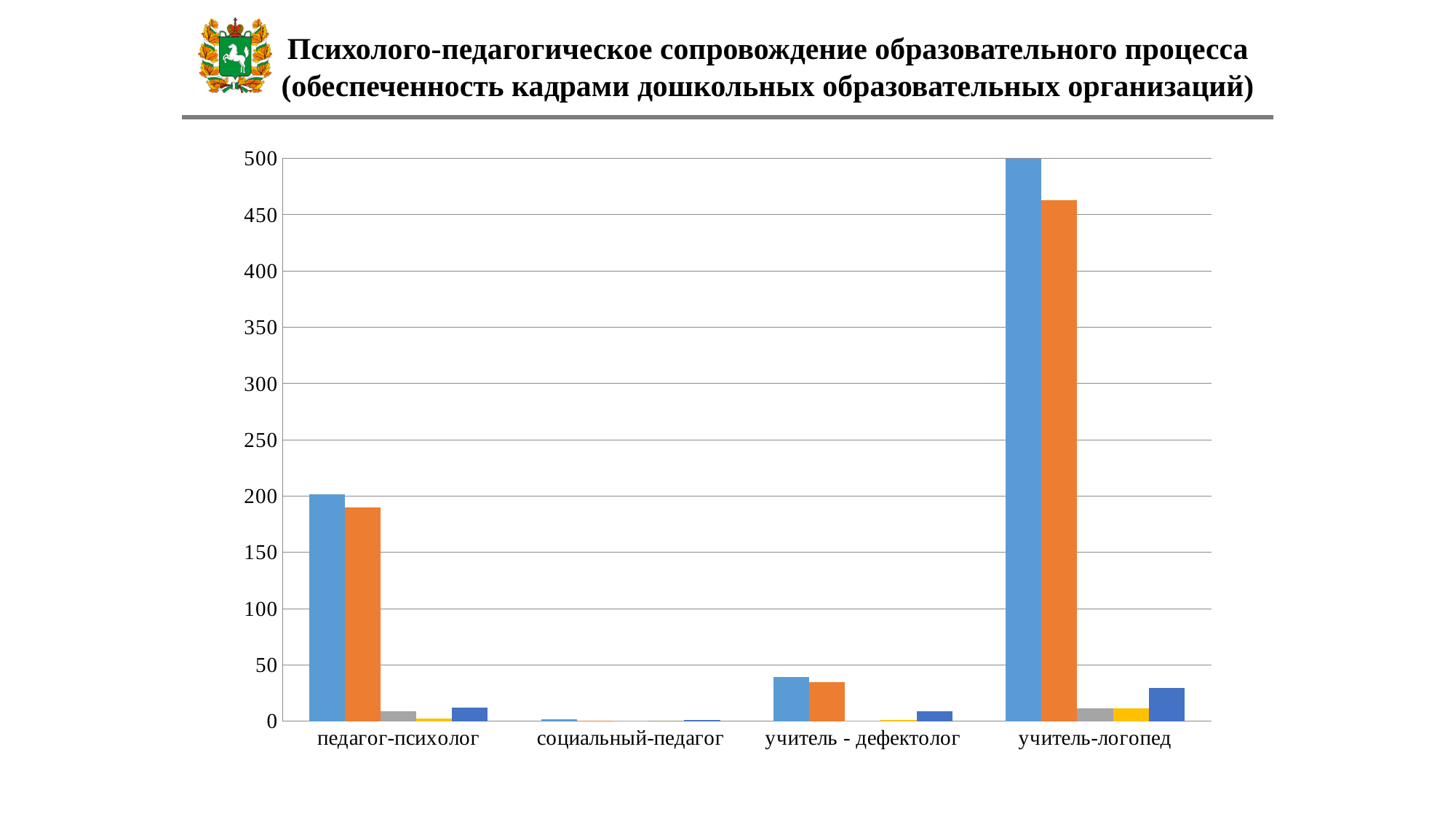
How many categories are shown on the x axis of the chart? 4 Which is larger, the blue bar for педагог-психолог or the blue bar for учитель - дефектолог? the blue bar for педагог-психолог Is the orange bar for педагог-психолог greater or less than 200? less Which category has the tallest blue bar? учитель-логопед What kind of chart is shown on the slide? bar chart Is the blue bar for учитель - дефектолог greater or less than 50? less Which category has the shortest blue bar? социальный-педагог Is the blue bar for педагог-психолог greater or less than 150? greater What is the highest value shown on the vertical axis of the chart? 500 Which is larger for учитель-логопед, the blue bar or the orange bar? the blue bar